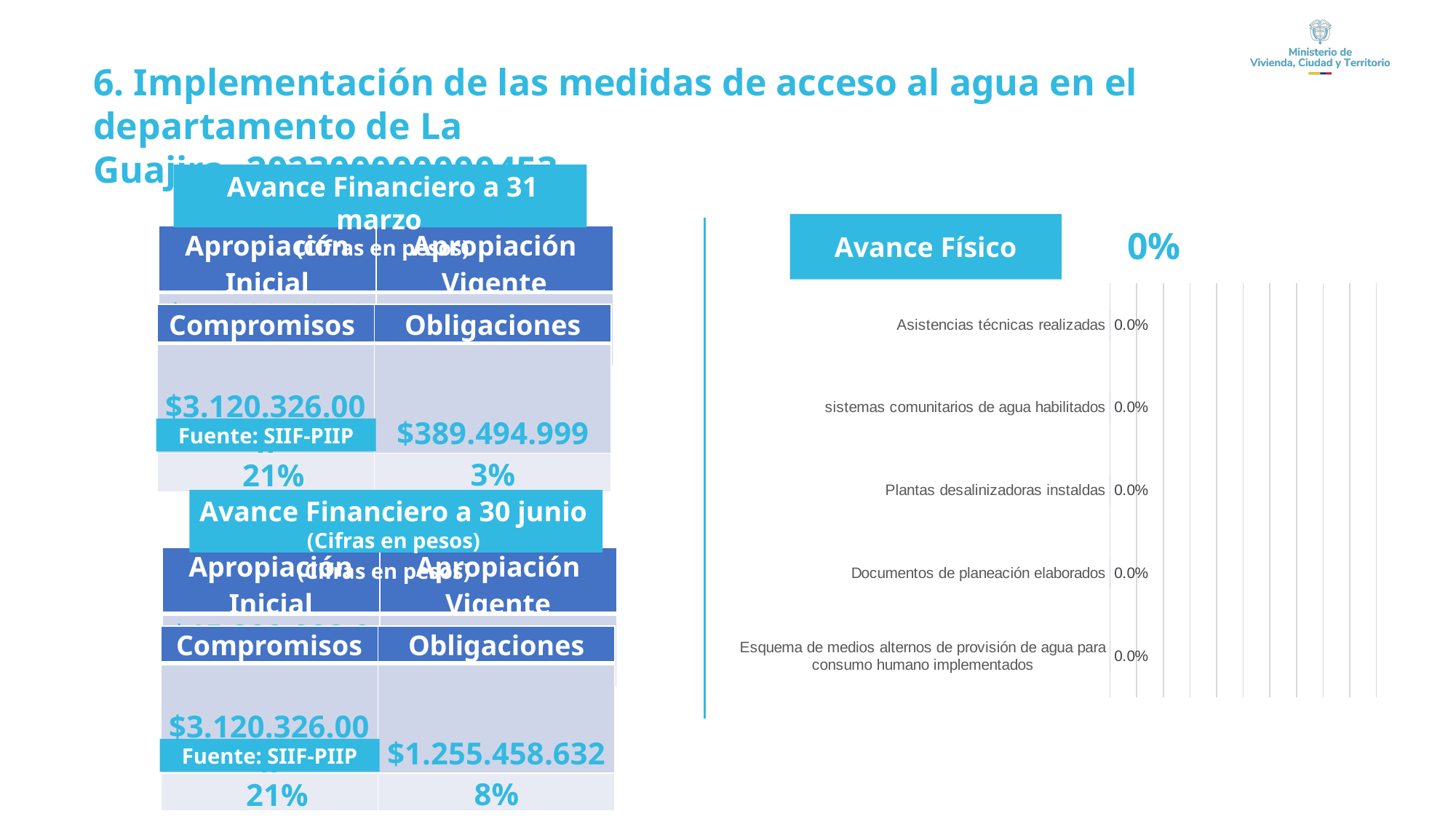
In the Avance Físico chart, what is the value for Plantas desalinizadoras instaladas? 0.0% What kind of chart is the Avance Físico chart? bar chart How many categories are shown in the Avance Físico chart? 5 In the Avance Físico chart, what is the value for Asistencias técnicas realizadas? 0.0% In the Avance Físico chart, what is the difference between the values for Asistencias técnicas realizadas and Plantas desalinizadoras instaladas? 0.0% What overall percentage is displayed next to the Avance Físico chart title? 0% What is the title of the chart on the right side of the slide? Avance Físico In the Avance Físico chart, what is the value for sistemas comunitarios de agua habilitados? 0.0% In the Avance Físico chart, what is the value for Esquema de medios alternos de provisión de agua para consumo humano implementados? 0.0% In the Avance Físico chart, what is the value for Documentos de planeación elaborados? 0.0%